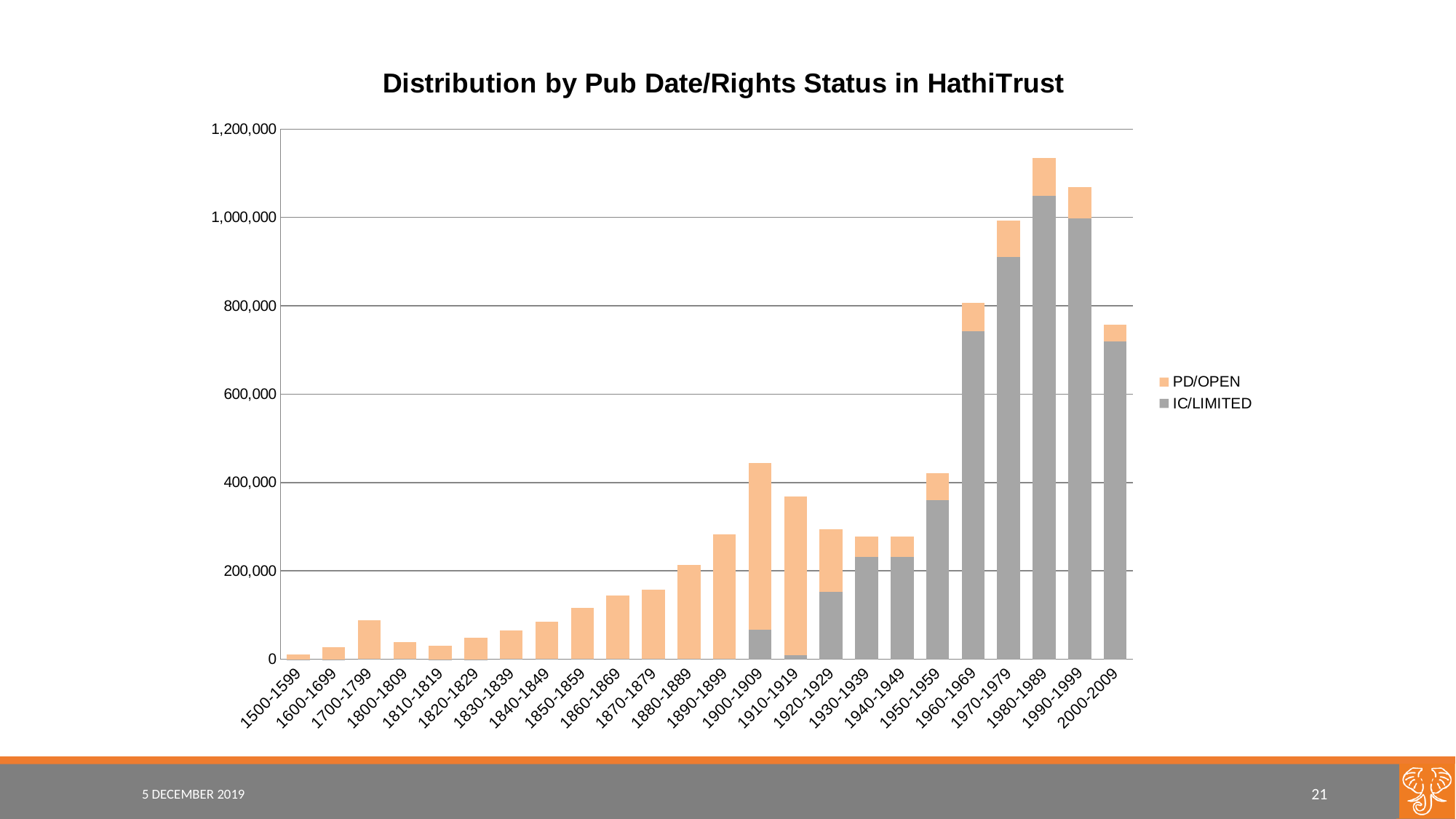
What is the title of the chart? Distribution by Pub Date/Rights Status in HathiTrust What kind of chart is shown on the slide? Stacked bar chart Which series is shown in orange in the legend? PD/OPEN Which has the larger total bar, 1980-1989 or 1990-1999? 1980-1989 Which publication date range has the highest total bar? 1980-1989 Is the total value for 1980-1989 greater or less than 1,000,000? greater Is the total value for 2000-2009 greater or less than 800,000? less How many publication date categories are shown on the x axis? 24 How many series does the legend list? 2 Which has the larger total bar, 1900-1909 or 1910-1919? 1900-1909 Which publication date range has the lowest total bar? 1500-1599 Is the total value for 1900-1909 greater or less than 400,000? greater